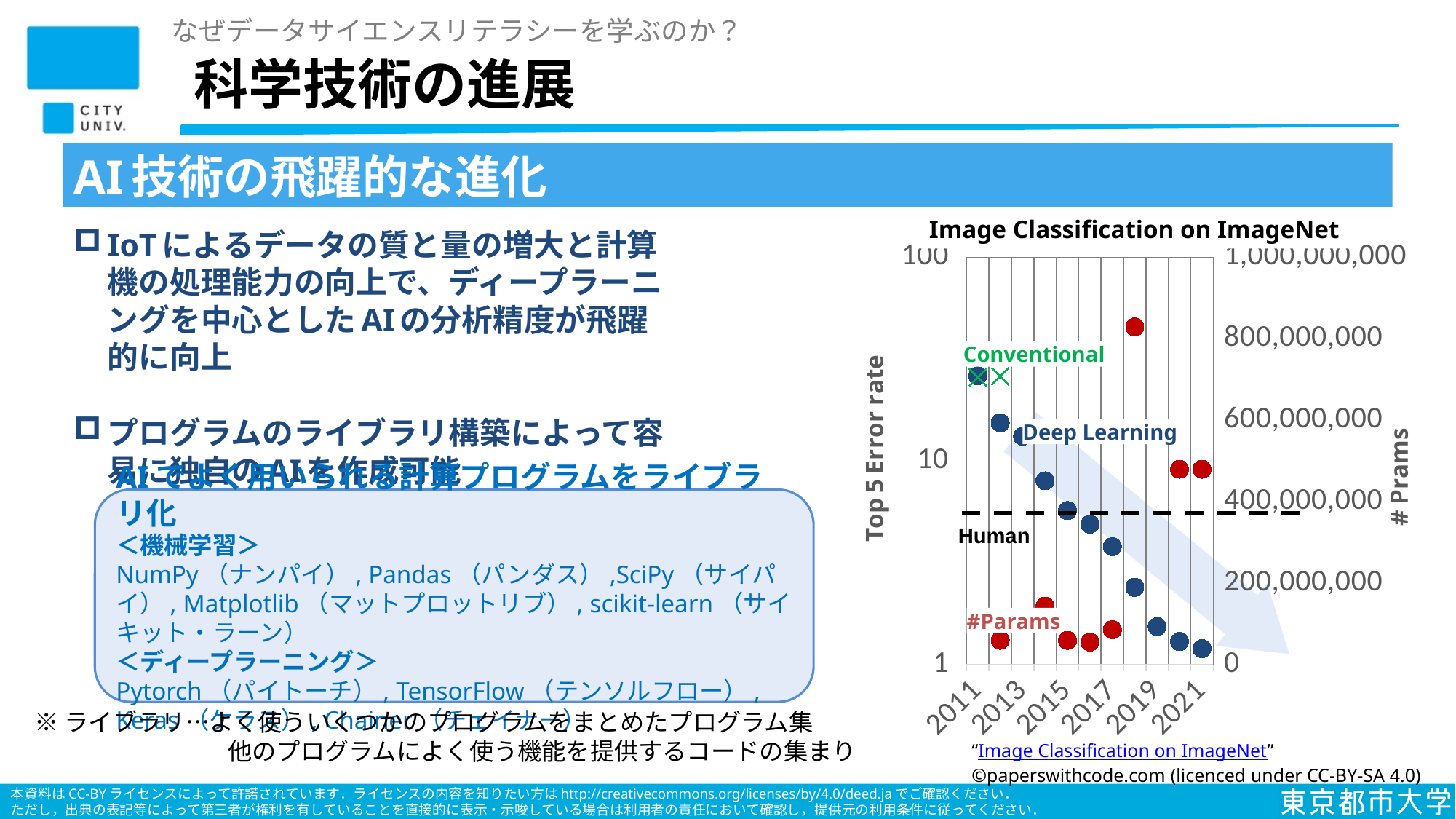
In the "Image Classification on ImageNet" chart, does the Deep Learning Top 5 Error rate rise or fall from 2012 to 2021? fall What is the label of the left vertical axis of the "Image Classification on ImageNet" chart? Top 5 Error rate In the "Image Classification on ImageNet" chart, how many labelled data series are plotted (excluding the Human reference line)? 3 In the "Image Classification on ImageNet" chart, which has the higher Top 5 Error rate: the Conventional point in 2011 or the Deep Learning point in 2012? Conventional in 2011 In the "Image Classification on ImageNet" chart, is the Deep Learning Top 5 Error rate in 2012 greater or less than 10? greater In the "Image Classification on ImageNet" chart, is the Conventional Top 5 Error rate in 2011 greater or less than 10? greater In the "Image Classification on ImageNet" chart, is the Deep Learning Top 5 Error rate in 2021 greater or less than 10? less What is the title of the chart on the right side of the slide? Image Classification on ImageNet In the "Image Classification on ImageNet" chart, which year has the highest #Params value? 2018 What kind of chart is "Image Classification on ImageNet"? scatter plot